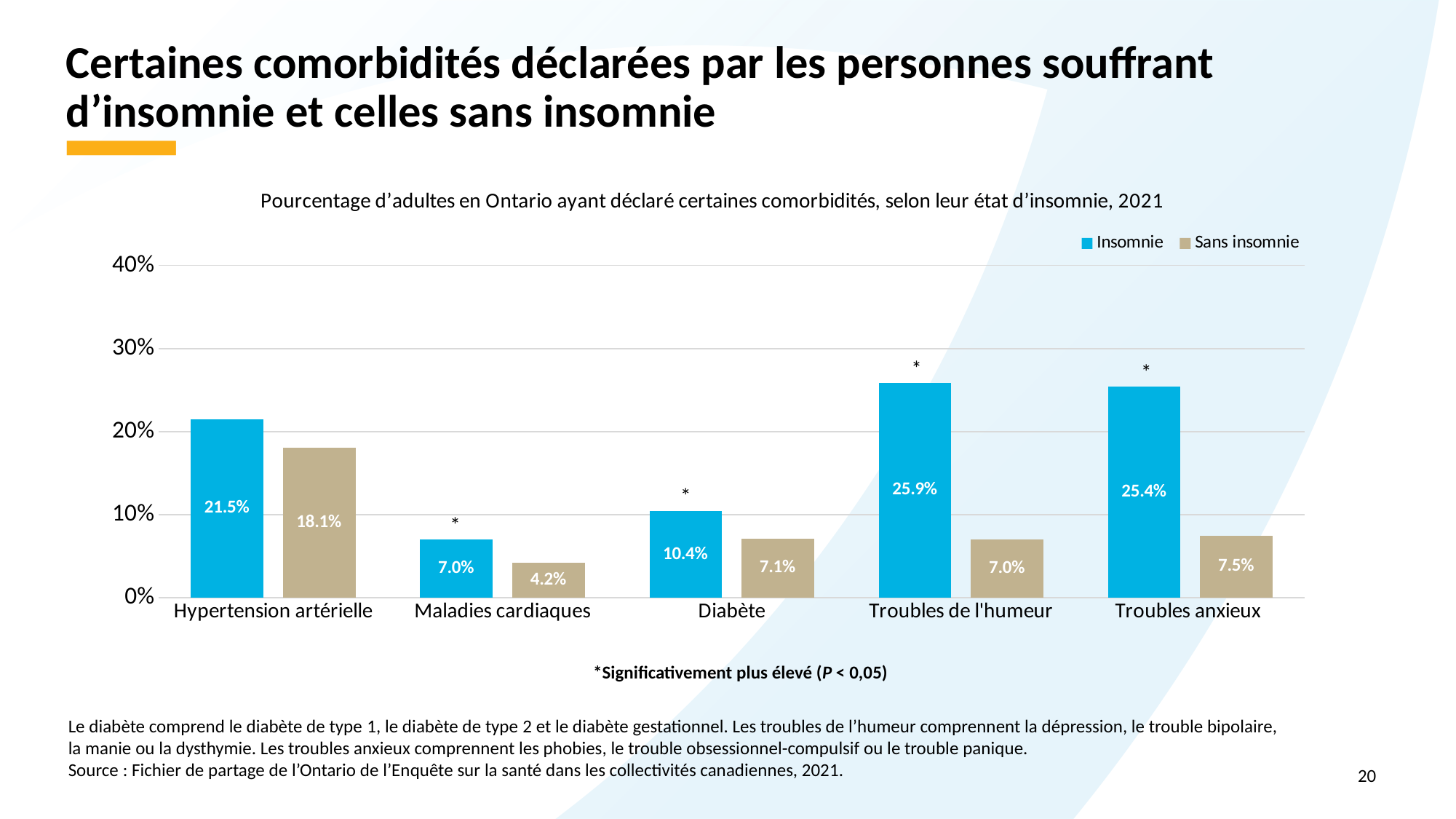
Which is larger for Diabète: the Insomnie value or the Sans insomnie value? Insomnie How many series does the legend list? 2 Which category has the highest value for the Insomnie series? Troubles de l'humeur Is the Insomnie value for Troubles anxieux greater or less than 20%? greater How many categories are shown on the x axis? 5 What is the difference between the Insomnie and Sans insomnie values for Troubles de l'humeur? 18.9% What is the value for Sans insomnie in the Maladies cardiaques category? 4.2% What kind of chart is shown on the slide? Bar chart What is the value for Insomnie in the Diabète category? 10.4% What is the value for Insomnie in the Hypertension artérielle category? 21.5% Which category has the lowest value for the Sans insomnie series? Maladies cardiaques What is the value for Sans insomnie in the Troubles anxieux category? 7.5%